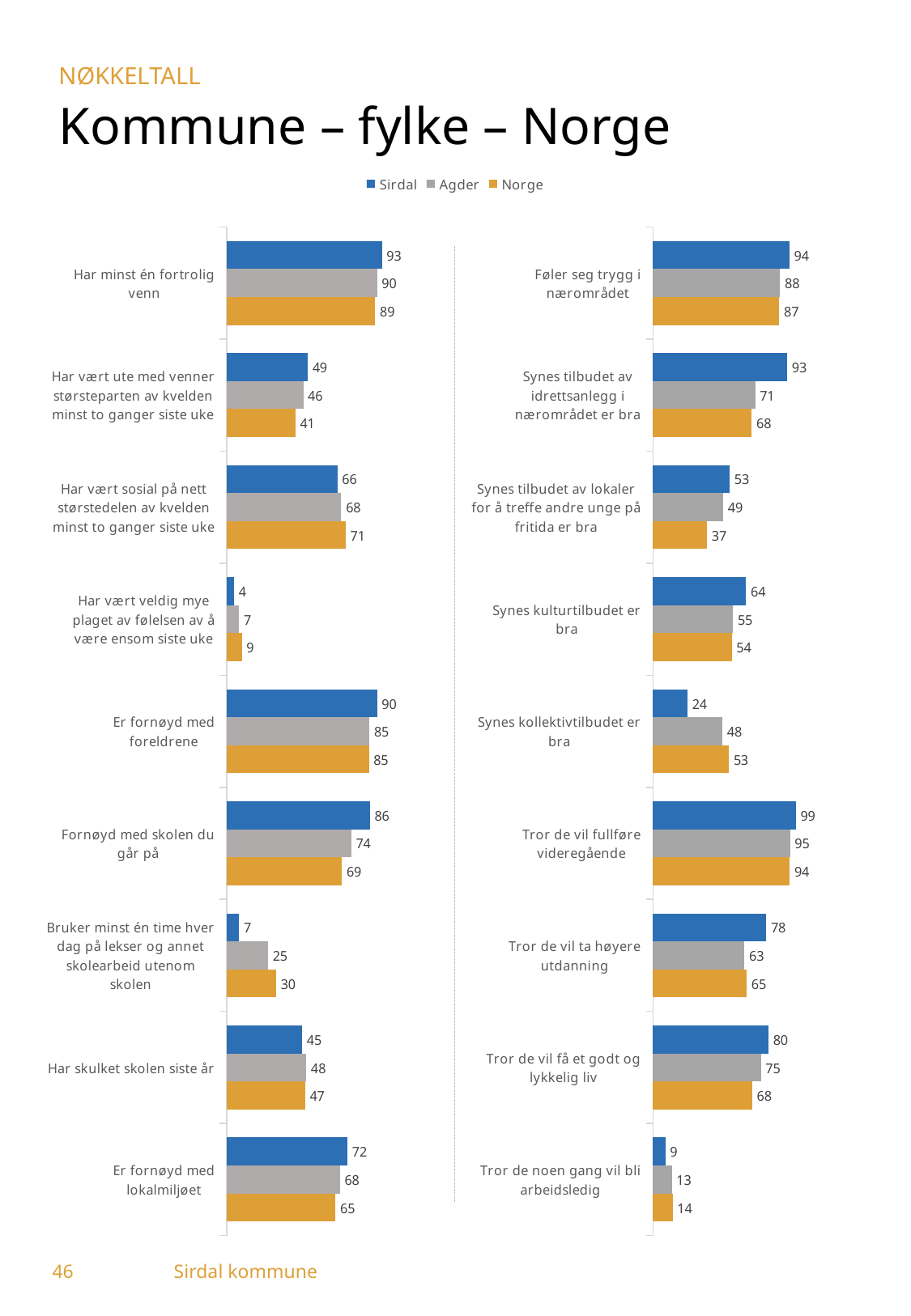
How many categories are shown in the left chart? 9 In the right chart, for "Tror de vil ta høyere utdanning", which is larger: the Agder value or the Norge value? Norge In the right chart, what is the Norge value for "Synes tilbudet av lokaler for å treffe andre unge på fritida er bra"? 37 In the left chart, which category has the lowest Sirdal value? Har vært veldig mye plaget av følelsen av å være ensom siste uke In the right chart, what is the difference between the Sirdal and Agder values for "Synes tilbudet av idrettsanlegg i nærområdet er bra"? 22 What type of chart is the right chart? Bar chart In the left chart, what is the difference between the Norge and Sirdal values for "Bruker minst én time hver dag på lekser og annet skolearbeid utenom skolen"? 23 In the right chart, which category has the highest Sirdal value? Tror de vil fullføre videregående In the left chart, what is the Sirdal value for "Fornøyd med skolen du går på"? 86 In the right chart, what is the Agder value for "Synes kollektivtilbudet er bra"? 48 How many series does the legend list? 3 In the left chart, for "Har vært sosial på nett størstedelen av kvelden minst to ganger siste uke", which is larger: the Sirdal value or the Norge value? Norge